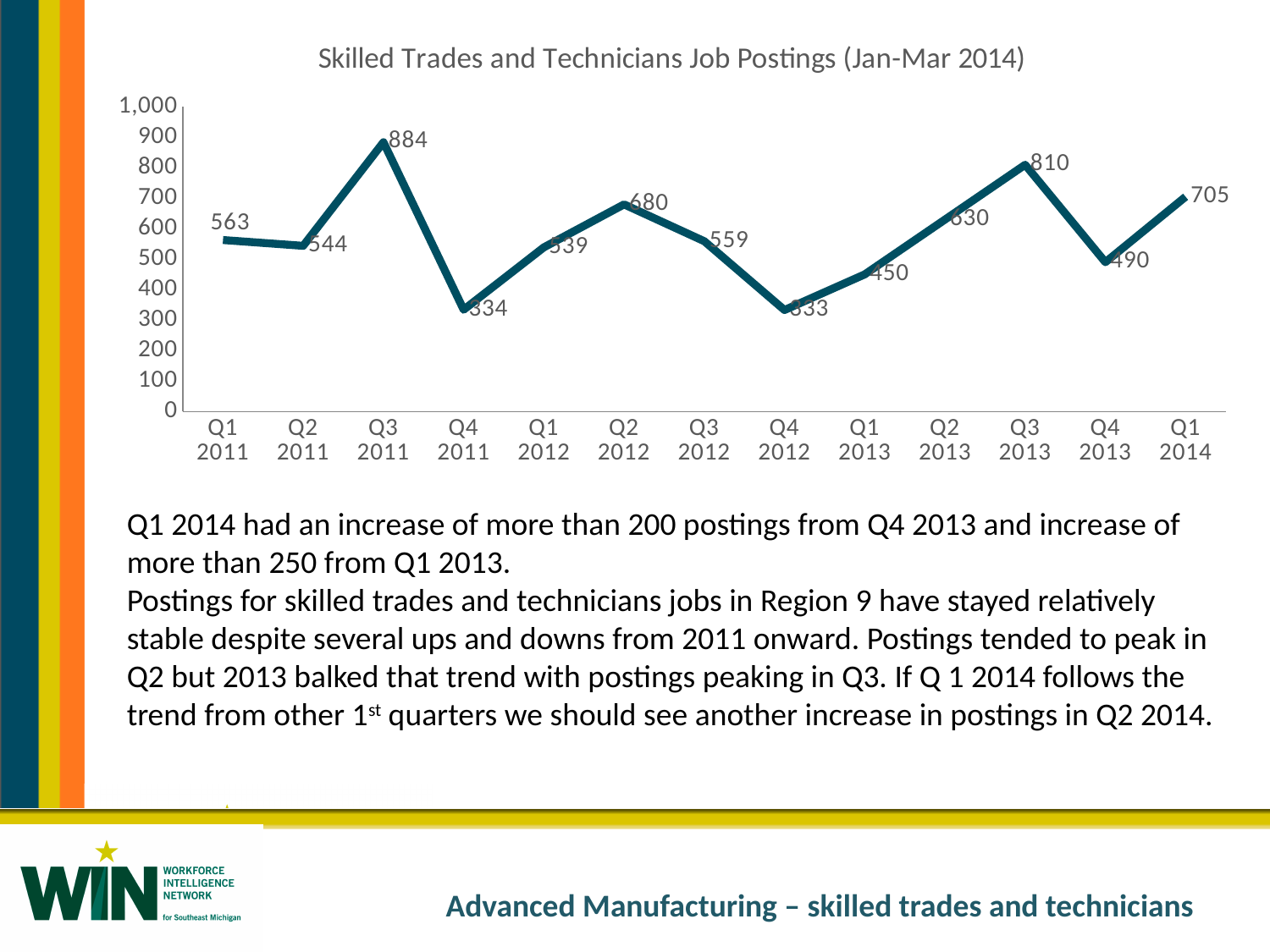
What is the value for Q4 2013? 490 What is the difference between the values for Q3 2013 and Q1 2013? 360 How many quarters are plotted on the x axis? 13 Which quarter has the highest number of job postings? Q3 2011 Is the value for Q4 2011 greater or less than 400? less What is the title of the chart? Skilled Trades and Technicians Job Postings (Jan-Mar 2014) What is the difference between the values for Q1 2014 and Q4 2013? 215 Which is larger, the value for Q3 2013 or the value for Q3 2012? Q3 2013 How many job postings were there in Q3 2011? 884 What is the value for Q2 2012? 680 What type of chart is shown on the slide? Line chart What is the value for Q1 2014? 705